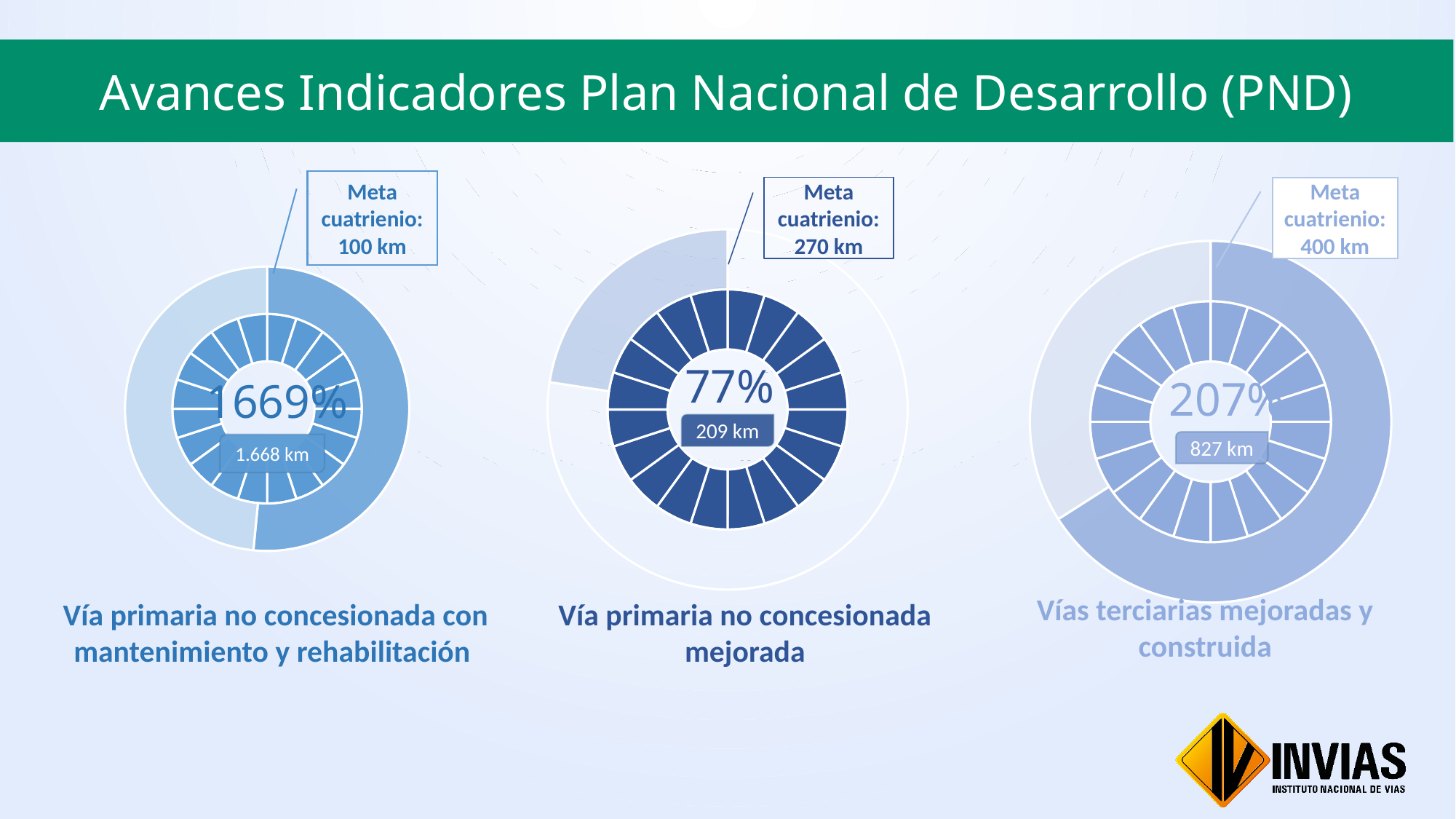
How many charts are shown on the slide? 3 In the chart titled 'Vías terciarias mejoradas y construida', what is the 'Meta cuatrienio' value? 400 km In the chart titled 'Vía primaria no concesionada mejorada', how many km have been achieved? 209 km In the chart titled 'Vía primaria no concesionada mejorada', what is the 'Meta cuatrienio' value? 270 km In the chart titled 'Vía primaria no concesionada mejorada', how many km short of the 'Meta cuatrienio' is the achieved value? 61 km Which of the three charts on the slide shows the highest percentage of progress? Vía primaria no concesionada con mantenimiento y rehabilitación In the chart titled 'Vías terciarias mejoradas y construida', by how many km does the achieved value exceed the 'Meta cuatrienio'? 427 km Which of the three charts on the slide shows the lowest percentage of progress? Vía primaria no concesionada mejorada Which chart has the larger 'Meta cuatrienio': 'Vía primaria no concesionada mejorada' or 'Vías terciarias mejoradas y construida'? Vías terciarias mejoradas y construida In the chart titled 'Vía primaria no concesionada con mantenimiento y rehabilitación', what percentage of progress is shown? 1669% In the chart titled 'Vía primaria no concesionada con mantenimiento y rehabilitación', how many km have been achieved? 1.668 km In the chart titled 'Vías terciarias mejoradas y construida', what percentage of progress is shown? 207%